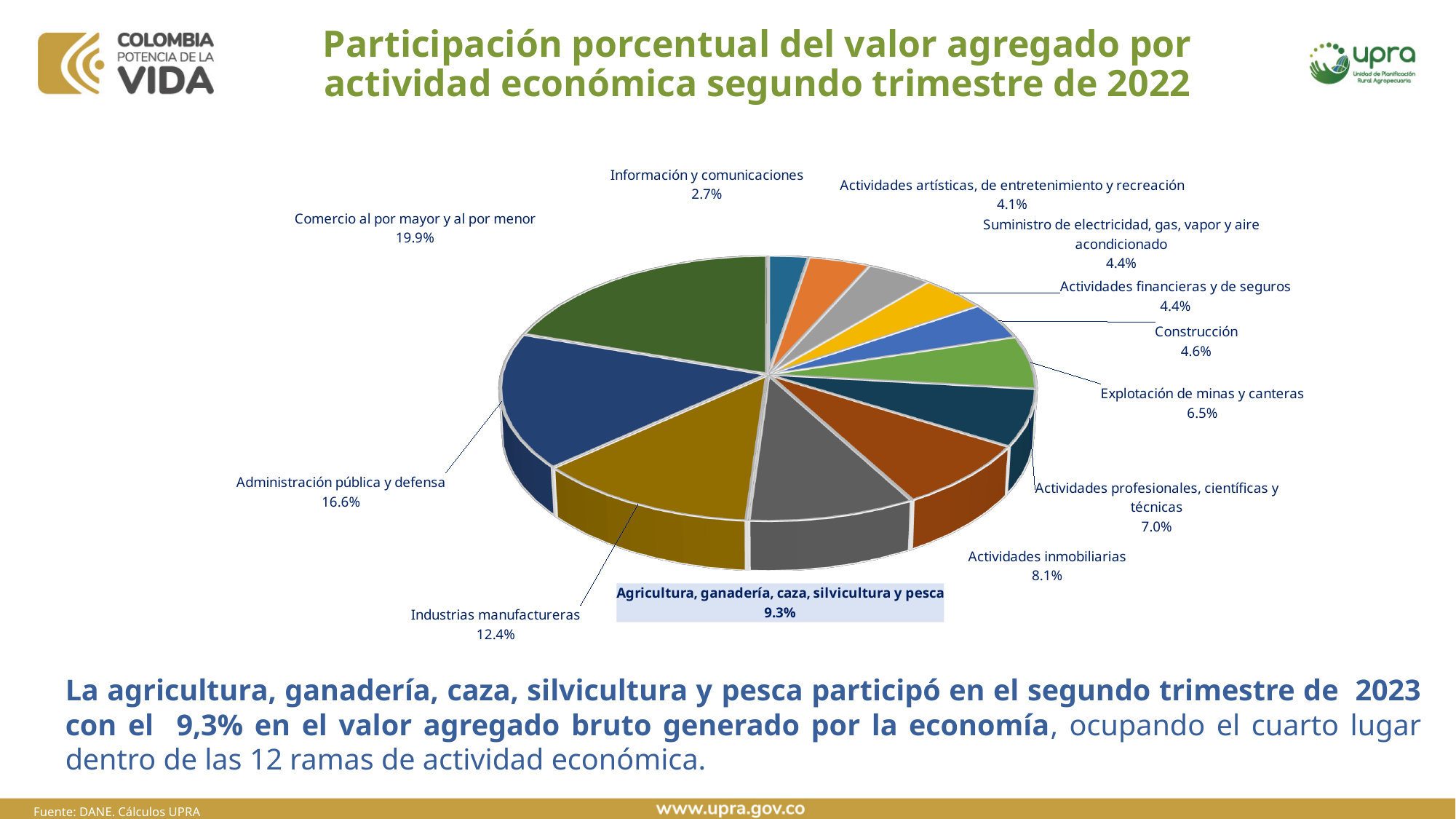
What share does Comercio al por mayor y al por menor have in the pie chart? 19.9% What is the difference between the shares of Administración pública y defensa and Industrias manufactureras? 4.2% Which economic activity has the largest share in the pie chart? Comercio al por mayor y al por menor What is the difference between the shares of Construcción and Información y comunicaciones? 1.9% What is the title of the chart on the slide? Participación porcentual del valor agregado por actividad económica segundo trimestre de 2022 Which has a larger share, Actividades inmobiliarias or Actividades profesionales, científicas y técnicas? Actividades inmobiliarias What is the value for Explotación de minas y canteras? 6.5% How many economic activities (slices) are shown in the pie chart? 12 What is the value shown for Agricultura, ganadería, caza, silvicultura y pesca? 9.3% What kind of chart is shown on the slide? Pie chart What percentage is shown for Industrias manufactureras? 12.4% Which economic activity has the smallest share in the pie chart? Información y comunicaciones